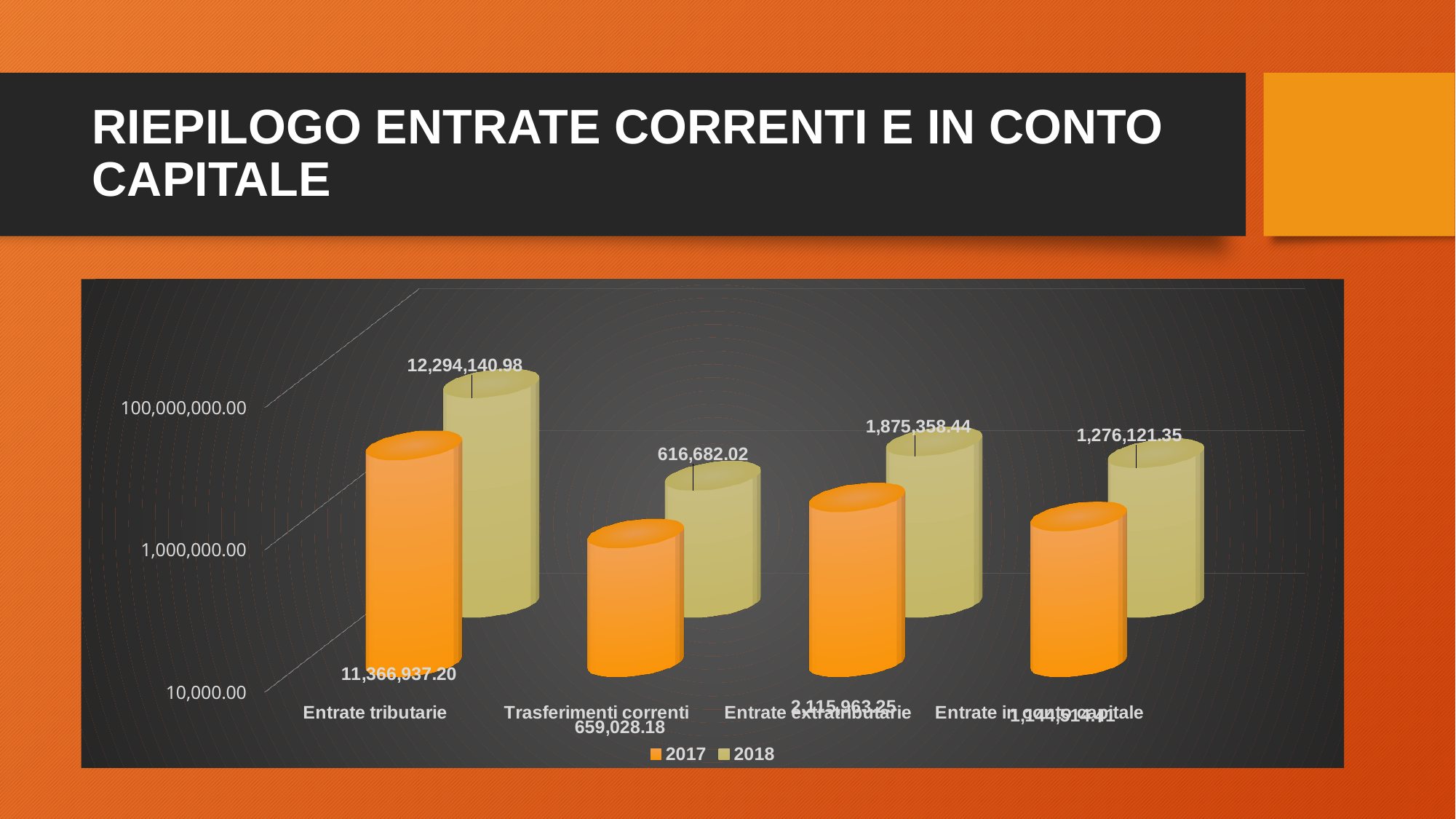
What is the 2018 value for Entrate tributarie? 12,294,140.98 What is the 2018 value for Entrate extratributarie? 1,875,358.44 What is the 2017 value for Entrate tributarie? 11,366,937.20 Which category has the highest 2018 value? Entrate tributarie How many categories are shown on the x axis? 4 What is the 2018 value for Entrate in conto capitale? 1,276,121.35 Which category has the lowest 2018 value? Trasferimenti correnti What is the 2017 value for Trasferimenti correnti? 659,028.18 How many series does the legend list? 2 For Entrate tributarie, which year has the larger value, 2017 or 2018? 2018 What is the 2018 value for Trasferimenti correnti? 616,682.02 What is the difference between the 2018 and 2017 values for Entrate tributarie? 927,203.78